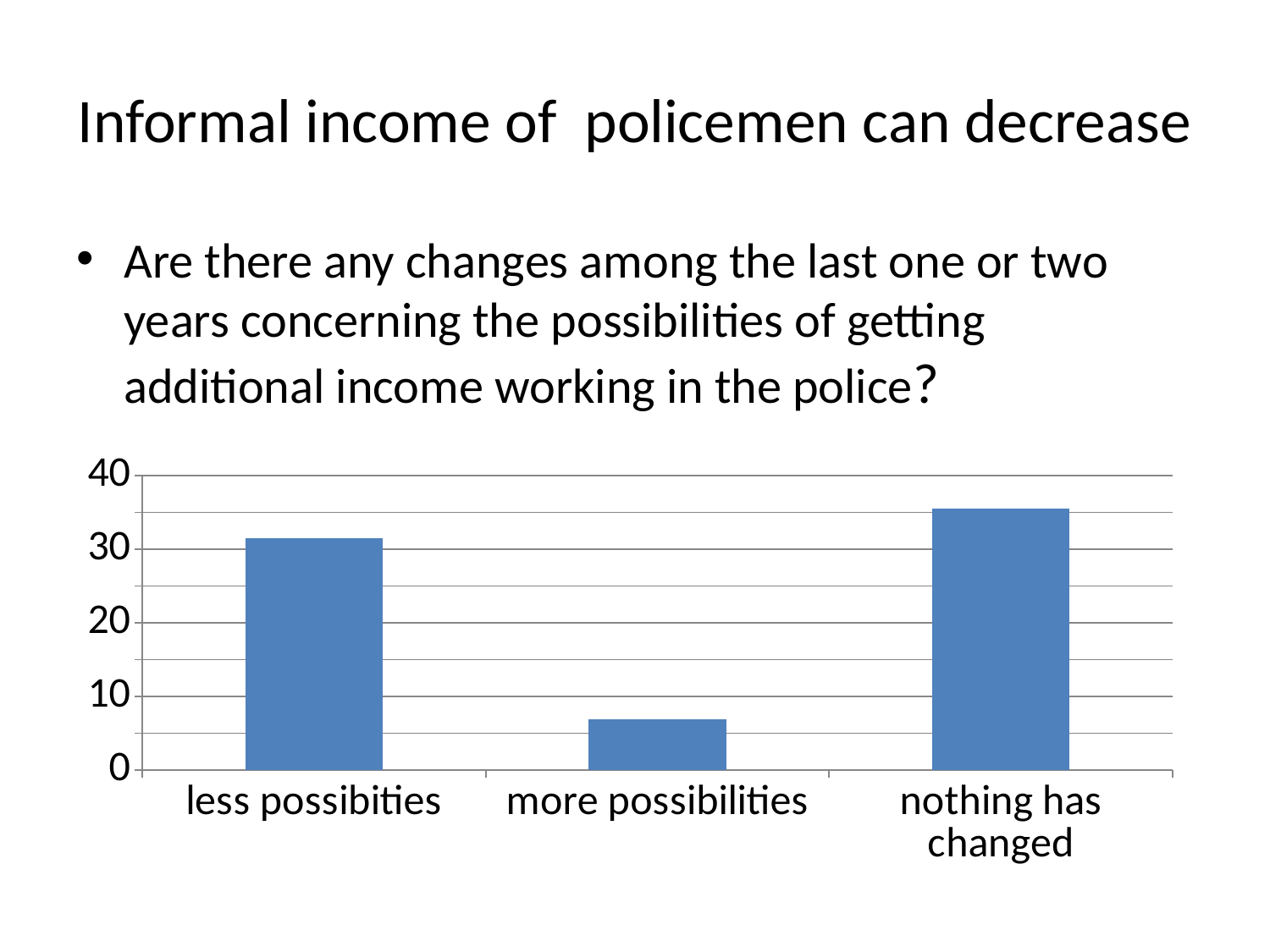
Which is larger, the value for less possibities or the value for more possibilities? less possibities Is the value for nothing has changed greater or less than 40? less Which is larger, the value for nothing has changed or the value for less possibities? nothing has changed What colour are the bars in the chart? blue Is the value for nothing has changed greater or less than 30? greater Which category has the highest bar in the chart? nothing has changed Is the value for more possibilities greater or less than 10? less What is the highest value shown on the chart's vertical axis? 40 How many categories are shown on the x axis of the chart? 3 Which category has the lowest bar in the chart? more possibilities What kind of chart is shown on the slide? bar chart